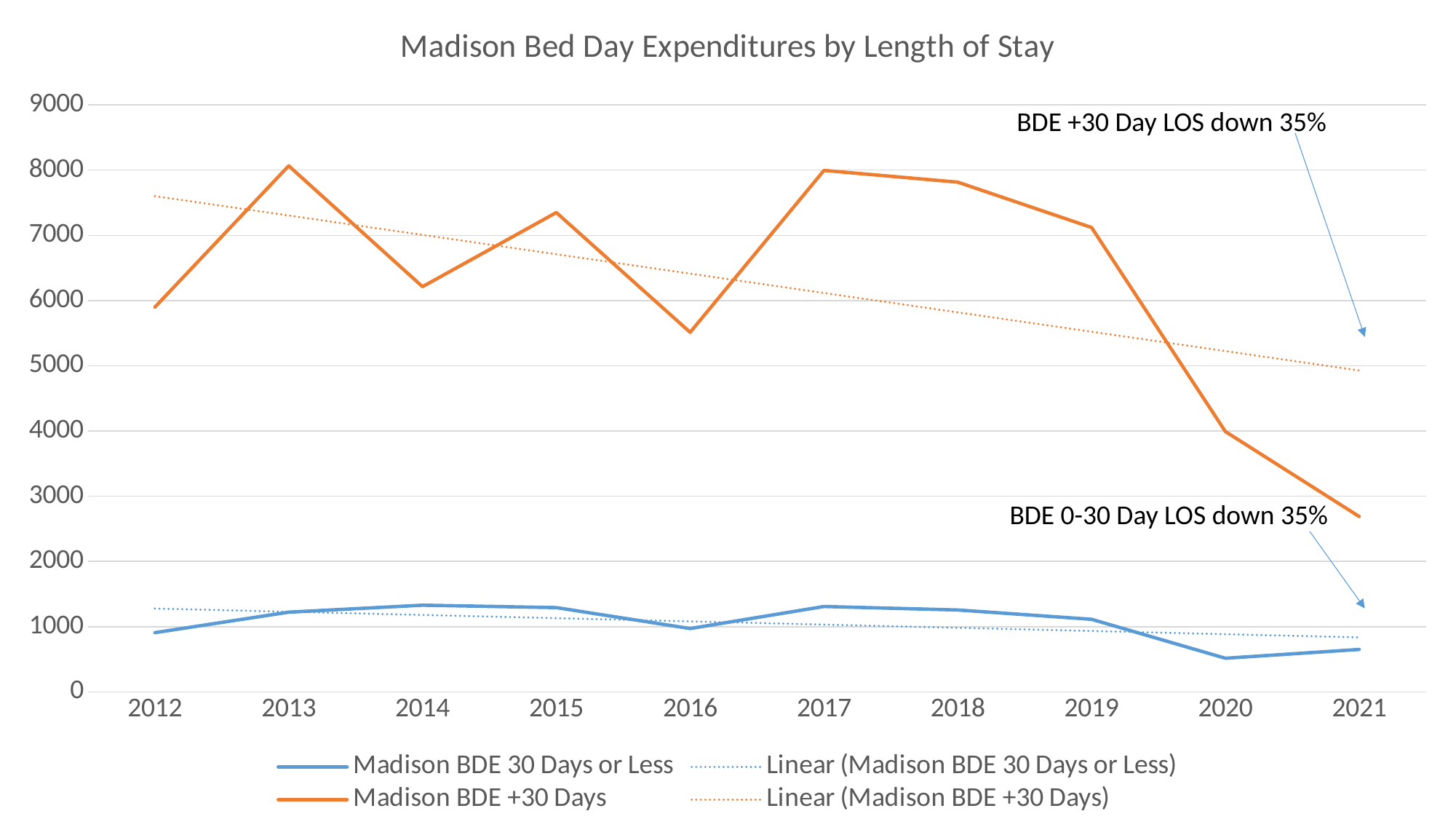
Does the Madison BDE +30 Days line rise or fall from 2019 to 2021? Fall In which year is the Madison BDE +30 Days value lowest? 2021 How many entries does the chart's legend list? 4 According to the annotation on the chart, by what percentage is BDE +30 Day LOS down? 35% Is the Madison BDE 30 Days or Less value for 2020 greater or less than 1000? less Is the Madison BDE +30 Days value for 2018 greater or less than 7000? greater What type of chart is shown on the slide? Line chart Which year has the larger Madison BDE +30 Days value, 2013 or 2014? 2013 Is the Madison BDE +30 Days value for 2020 greater or less than 5000? less What is the title of the chart? Madison Bed Day Expenditures by Length of Stay How many years are shown along the x axis? 10 In which year is the Madison BDE 30 Days or Less value lowest? 2020